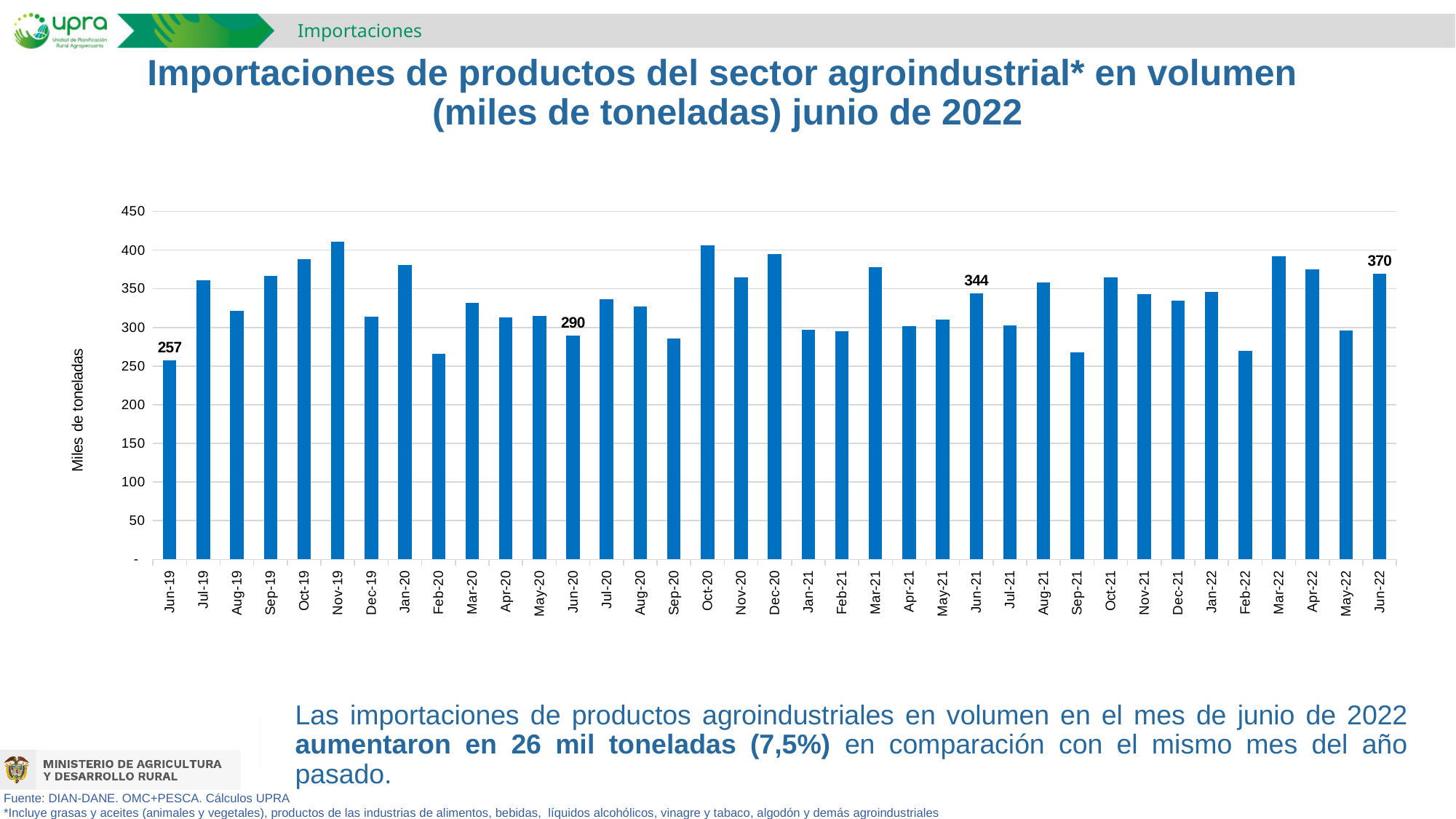
What kind of chart is shown on the slide? bar chart What is the value for Jun-20? 290 What is the value for Jun-22? 370 Is the value for Nov-19 greater or less than 400? greater What is the label of the vertical axis? Miles de toneladas How many months are plotted on the chart? 37 What is the value for Jun-21? 344 Which is larger, the value for Jun-22 or the value for Jun-19? Jun-22 Is the value for Feb-20 greater or less than 300? less What is the value for Jun-19? 257 What is the difference between the values for Jun-21 and Jun-20? 54 What is the difference between the values for Jun-22 and Jun-21? 26